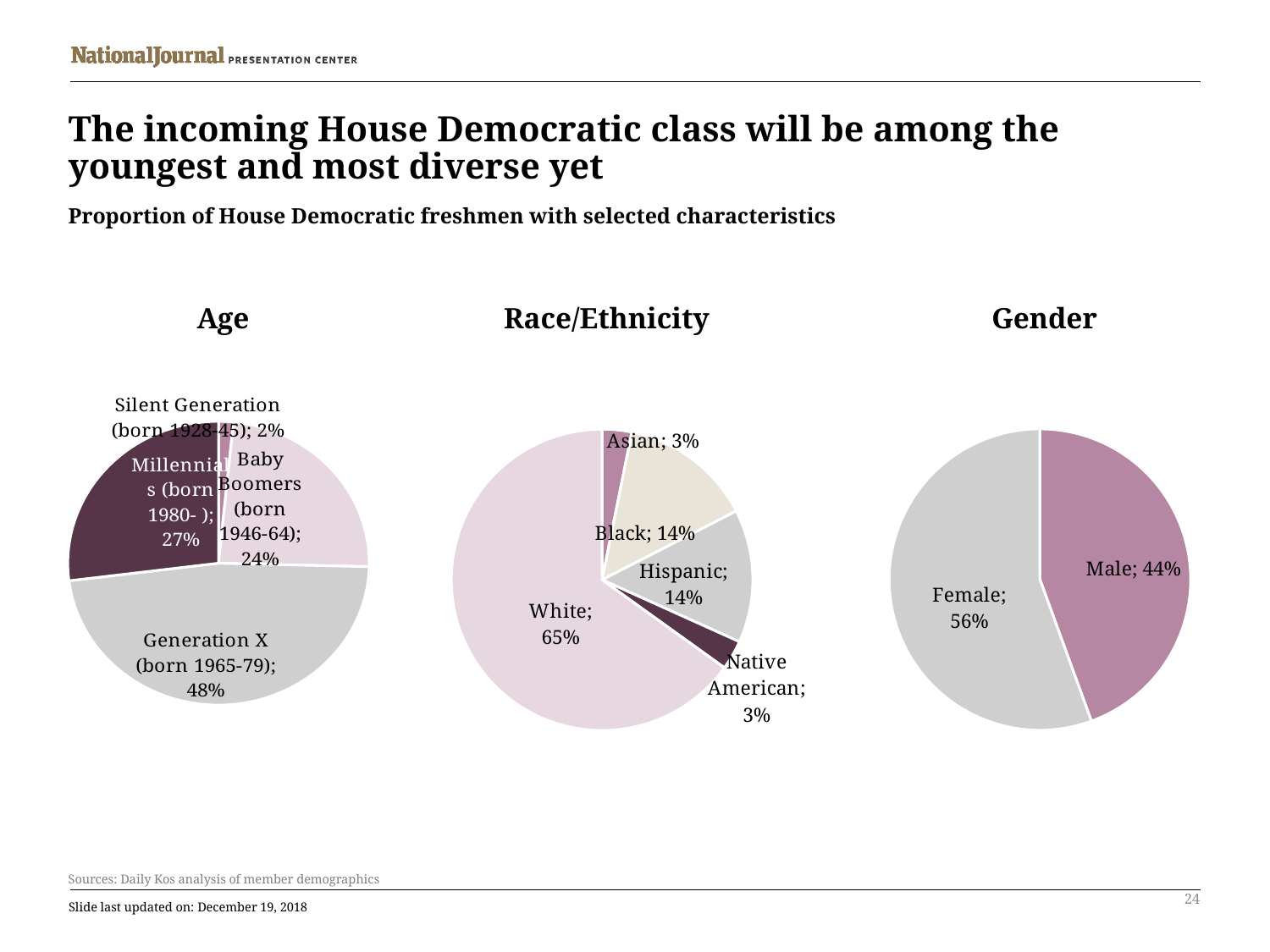
In the Race/Ethnicity chart, which is larger, the Black share or the Asian share? Black How many pie charts are shown on the slide? 3 In the Race/Ethnicity chart, what share of House Democratic freshmen are Hispanic? 14% In the Gender chart, what share of House Democratic freshmen are Female? 56% In the Age chart, what is the difference between the Generation X share and the Baby Boomers share? 24% In the Race/Ethnicity chart, what share of House Democratic freshmen are White? 65% In the Age chart, what share of House Democratic freshmen are Generation X (born 1965-79)? 48% What kind of chart is used for the Gender breakdown? Pie chart In the Gender chart, what is the difference between the Female share and the Male share? 12% In the Race/Ethnicity chart, how many race/ethnicity categories are shown? 5 In the Age chart, what share of House Democratic freshmen are Millennials (born 1980- )? 27% In the Age chart, which generation has the smallest share? Silent Generation (born 1928-45)